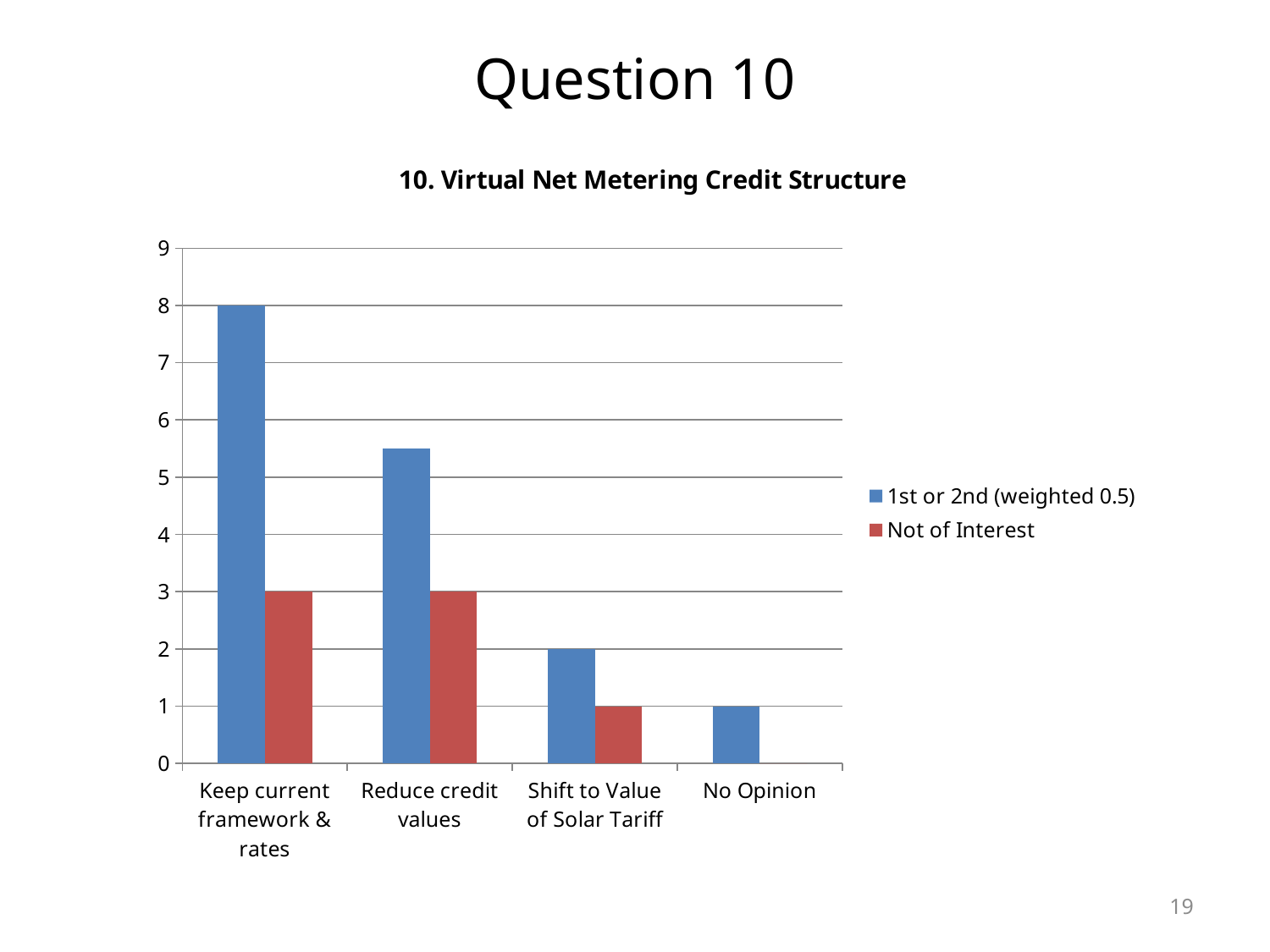
What is the value of '1st or 2nd (weighted 0.5)' for 'Keep current framework & rates'? 8 What is the value of 'Not of Interest' for 'Reduce credit values'? 3 How many categories are shown on the x axis? 4 What is the title of the chart? 10. Virtual Net Metering Credit Structure Which category has the lowest value for '1st or 2nd (weighted 0.5)'? No Opinion What is the value of '1st or 2nd (weighted 0.5)' for 'Shift to Value of Solar Tariff'? 2 What type of chart is shown on the slide? bar chart How many series does the legend list? 2 Which is larger for 'Shift to Value of Solar Tariff': '1st or 2nd (weighted 0.5)' or 'Not of Interest'? 1st or 2nd (weighted 0.5) Which category has the highest value for '1st or 2nd (weighted 0.5)'? Keep current framework & rates What is the difference between the '1st or 2nd (weighted 0.5)' and 'Not of Interest' values for 'Keep current framework & rates'? 5 Is the value of '1st or 2nd (weighted 0.5)' for 'Reduce credit values' greater or less than 5? greater